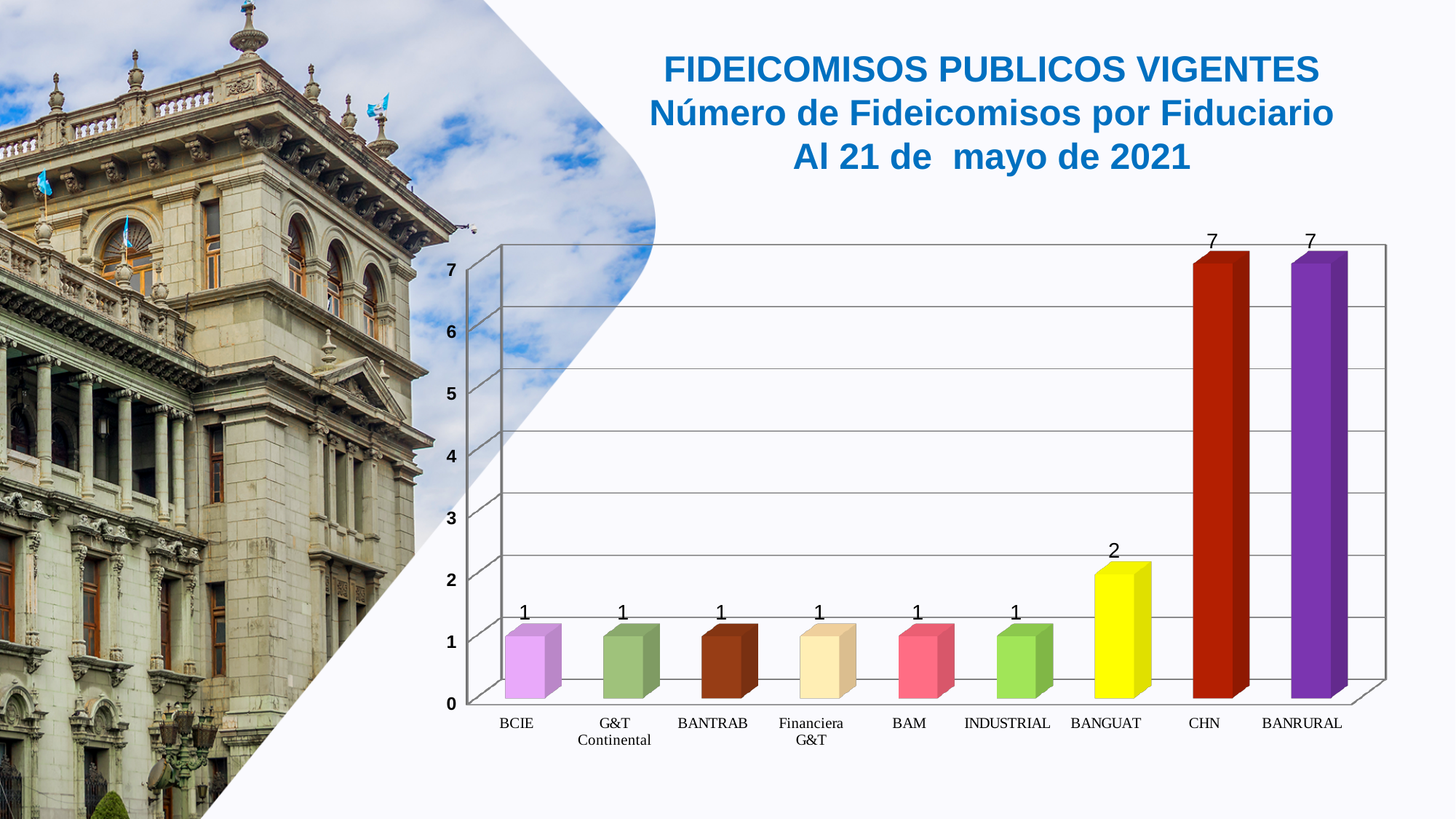
What is the value for CHN? 7 How many categories are shown on the x axis? 9 What is the value for BANGUAT? 2 What is the value for BCIE? 1 What is the value for INDUSTRIAL? 1 What is the difference between the values for CHN and BANGUAT? 5 What is the date given in the chart title? 21 de mayo de 2021 What is the difference between the values for BANGUAT and BAM? 1 What kind of chart is shown on the slide? bar chart Is the value for CHN greater or less than 5? greater Which category has the lowest value among BANGUAT, CHN and BANRURAL? BANGUAT Which is larger, the value for BANRURAL or the value for BANTRAB? BANRURAL